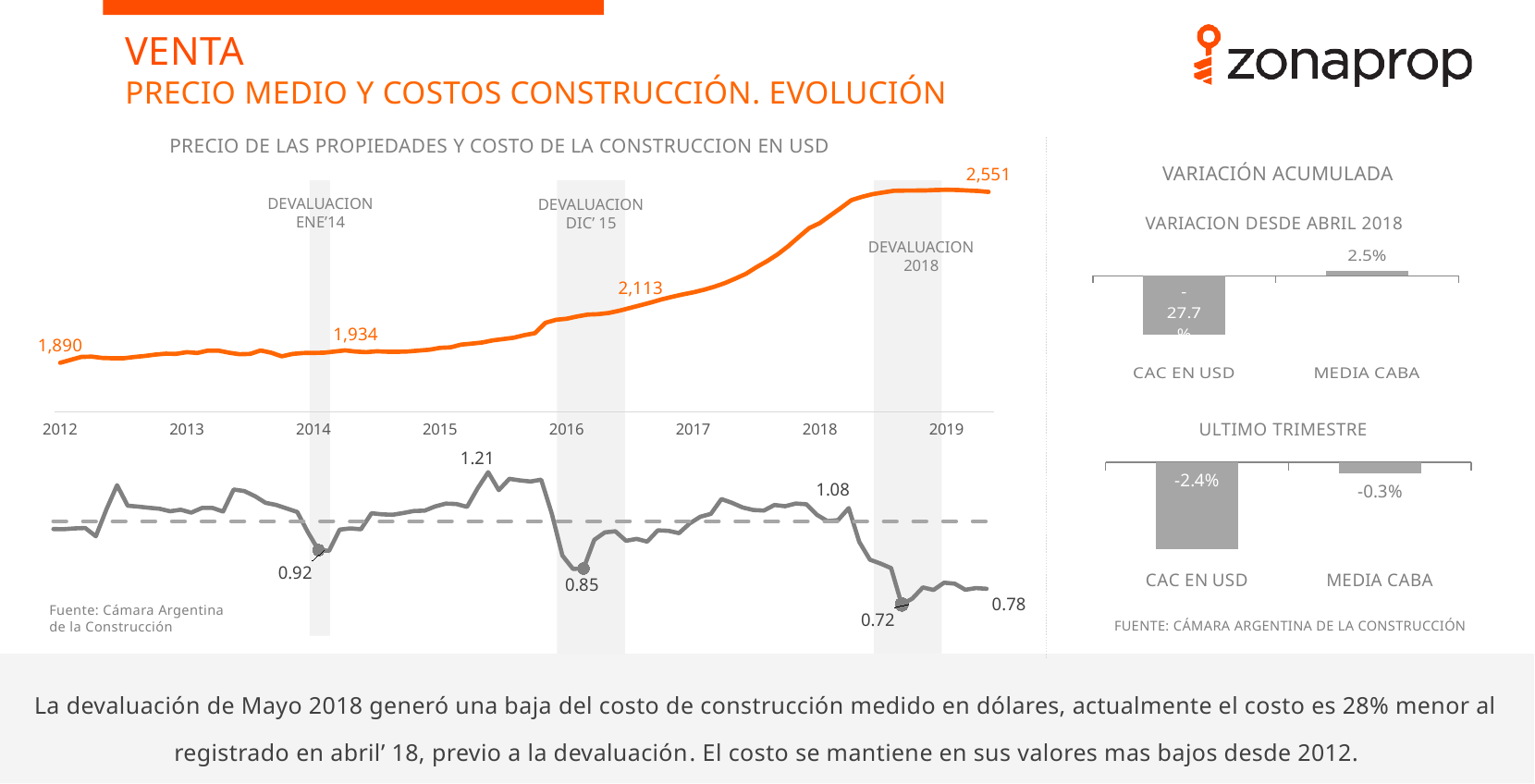
In the bar chart 'ULTIMO TRIMESTRE', which category has the lower value, CAC EN USD or MEDIA CABA? CAC EN USD In the bar chart 'VARIACION DESDE ABRIL 2018', what is the value for CAC EN USD? -27.7% In the chart 'PRECIO DE LAS PROPIEDADES Y COSTO DE LA CONSTRUCCION EN USD', does the orange line generally rise or fall from 2012 to 2019? rise In the grey line chart at the bottom left, what is the value labelled near the 'DEVALUACION DIC' 15' shaded band? 0.85 In the grey line chart at the bottom left, what is the highest labelled value? 1.21 In the chart 'PRECIO DE LAS PROPIEDADES Y COSTO DE LA CONSTRUCCION EN USD', what is the difference between the final labelled value (2,551) and the first labelled value (1,890) on the orange line? 661 In the grey line chart at the bottom left, what is the value labelled at the end of the line in 2019? 0.78 In the chart 'PRECIO DE LAS PROPIEDADES Y COSTO DE LA CONSTRUCCION EN USD', what is the value labelled at the start of the orange line in 2012? 1,890 In the bar chart 'VARIACION DESDE ABRIL 2018', what is the value for MEDIA CABA? 2.5% In the bar chart 'ULTIMO TRIMESTRE', what is the value for MEDIA CABA? -0.3% In the chart 'PRECIO DE LAS PROPIEDADES Y COSTO DE LA CONSTRUCCION EN USD', what is the latest value labelled at the end of the orange line in 2019? 2,551 In the grey line chart at the bottom left, what is the lowest labelled value? 0.72